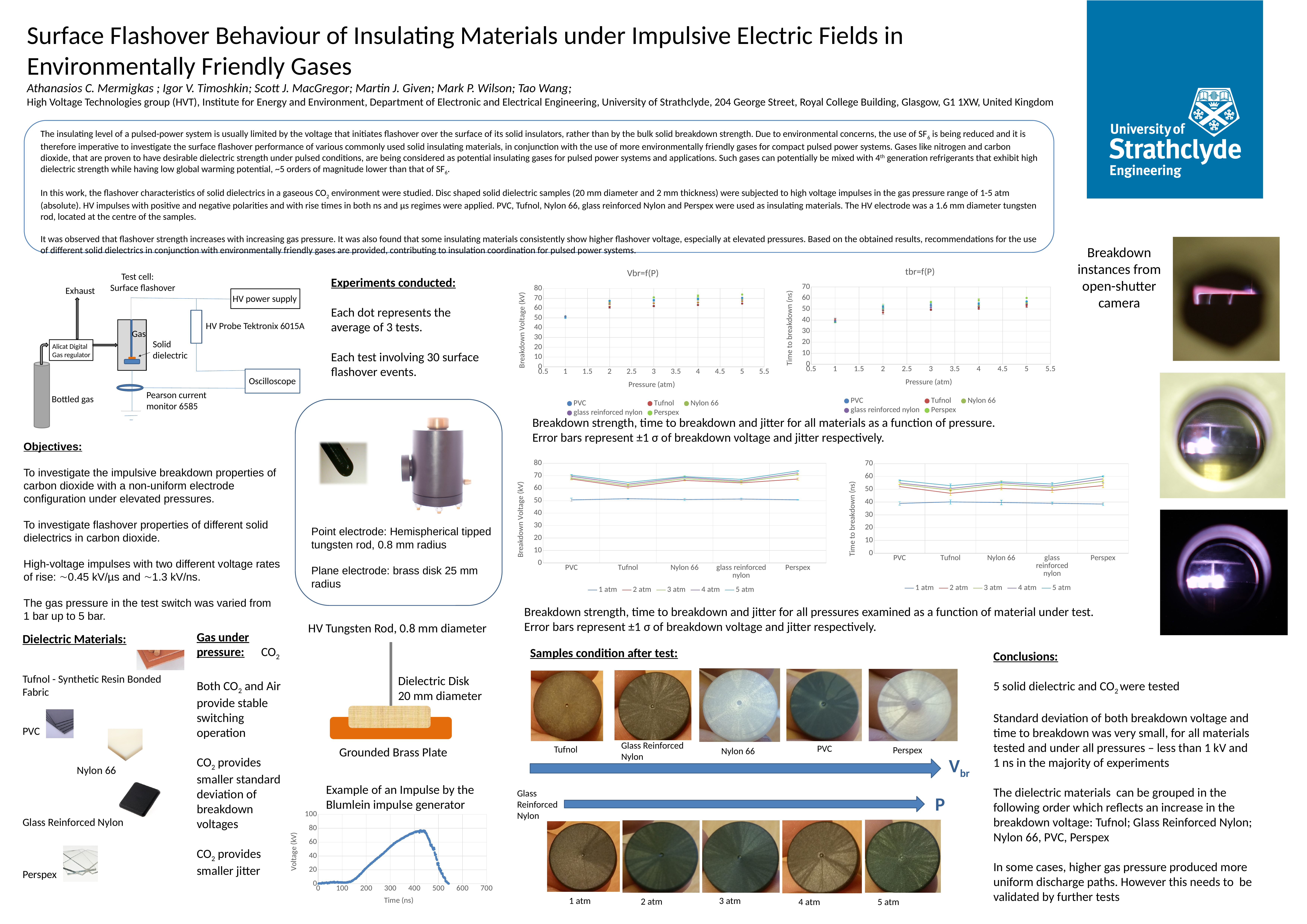
In the chart titled Vbr=f(P), is the breakdown voltage at 1 atm greater or less than 60 kV? less In the line chart of Breakdown Voltage (kV) versus material, how many materials are shown on the x axis? 5 In the chart titled Example of an Impulse by the Blumlein impulse generator, is the peak voltage greater or less than 60 kV? greater In the line chart of Breakdown Voltage (kV) versus material, is the 1 atm value for Perspex greater or less than 60 kV? less In the chart titled Vbr=f(P), how many series does the legend list? 5 In the chart titled Vbr=f(P), do the breakdown voltage values rise or fall as pressure increases from 1 atm to 5 atm? rise In the line chart of Breakdown Voltage (kV) versus material (lower left of the chart area), how many series does the legend list? 5 In the chart titled tbr=f(P), what is the label of the y axis? Time to breakdown (ns) In the chart titled Vbr=f(P), how many pressure values are plotted for each material? 5 In the chart titled Vbr=f(P), what kind of chart is it? scatter chart